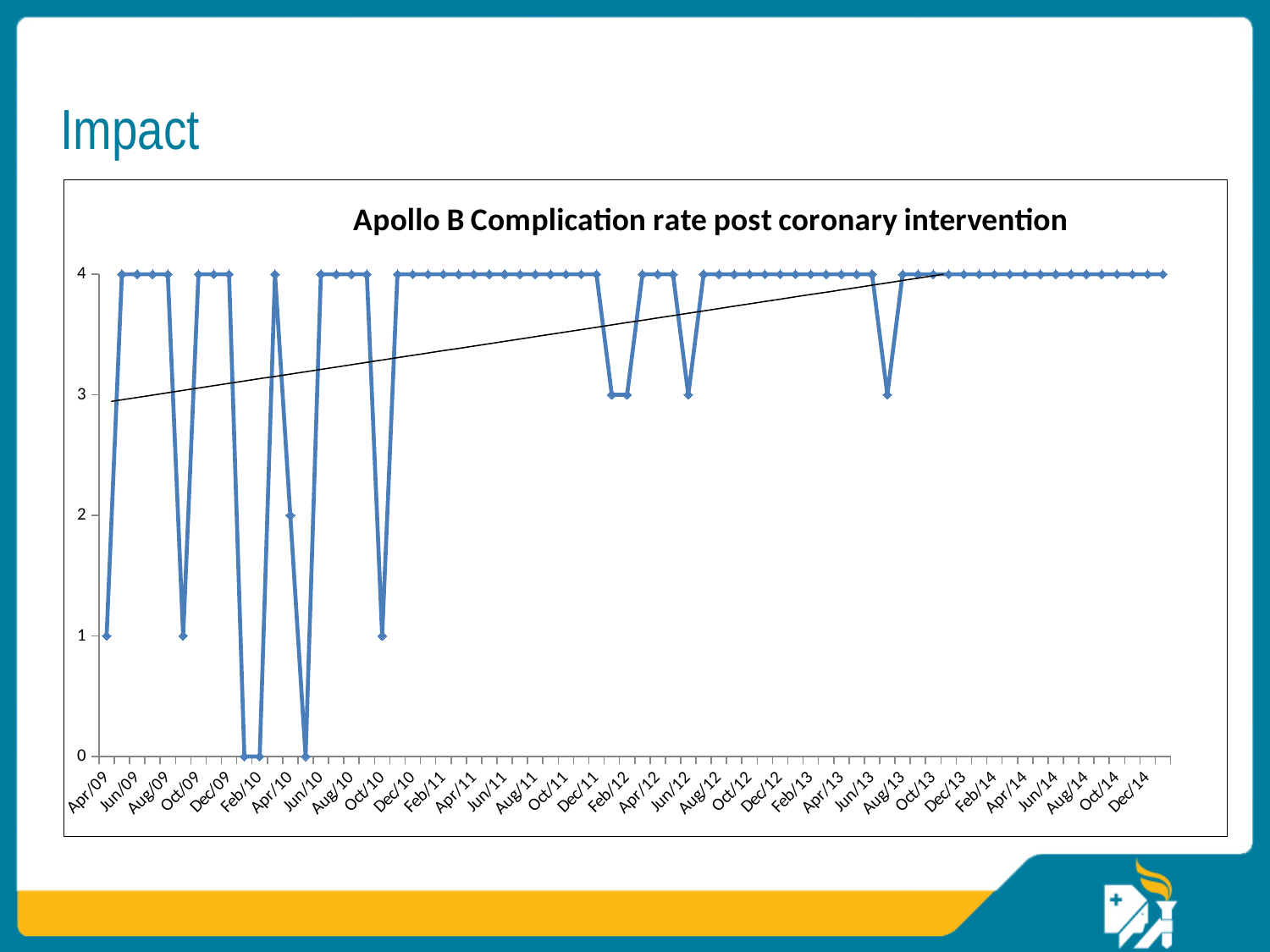
What is the lowest value reached by the line? 0 What is the value plotted for Jun/12? 3 Which has the larger value, Apr/10 or Jun/12? Jun/12 What is the title of the chart? Apollo B Complication rate post coronary intervention What is the value plotted for Feb/10? 0 What kind of chart is shown on the slide? line chart What is the highest value reached by the line? 4 What is the difference between the value for Dec/14 and the value for Apr/09? 3 What is the value plotted for Apr/09? 1 What is the value plotted for Dec/14? 4 What is the value plotted for Apr/10? 2 What is the value plotted for Oct/10? 1